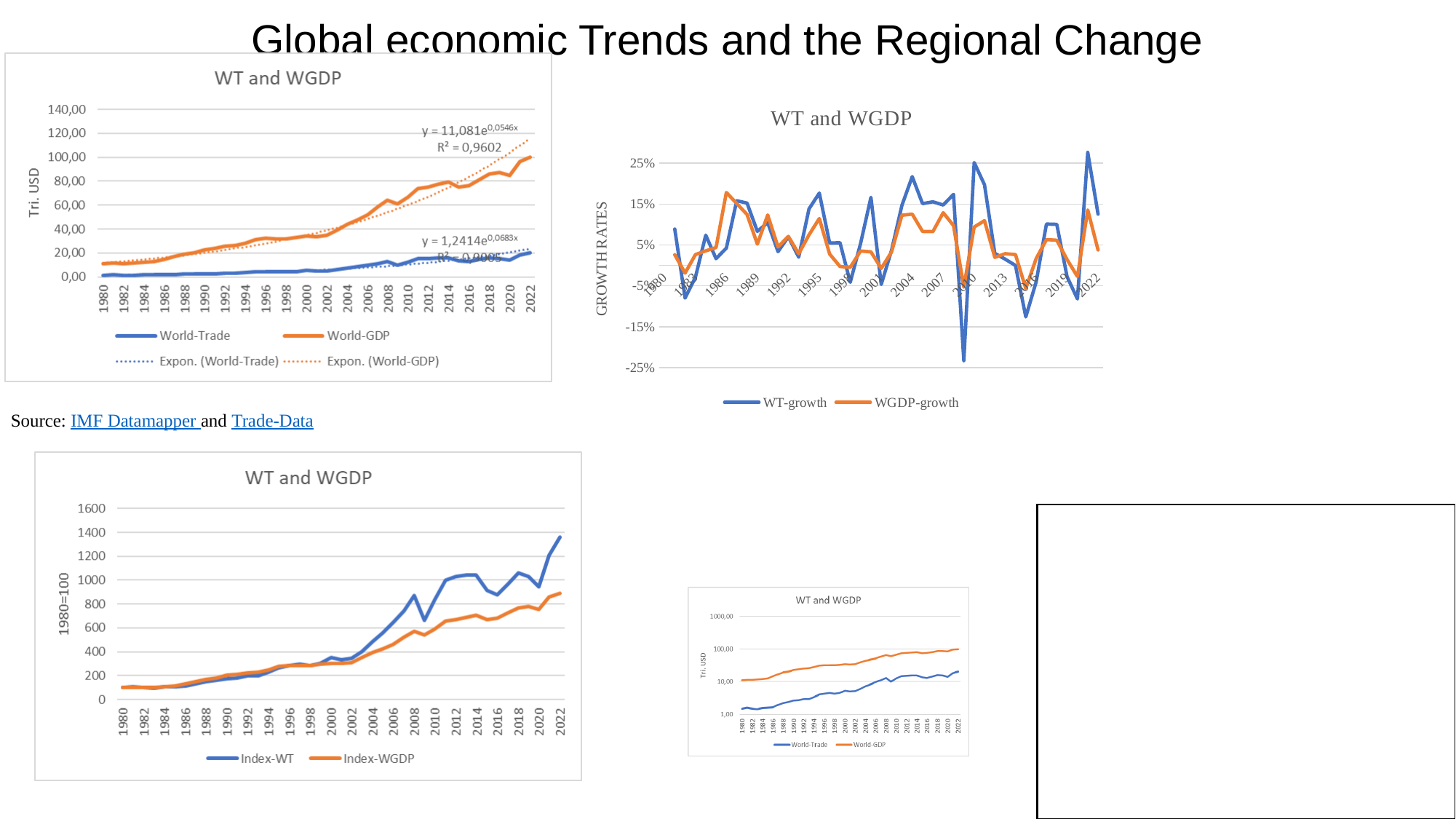
How many entries does the legend of the top-left chart list? 4 In the top-left chart, what is the R² value shown for the exponential trendline of World-GDP? R² = 0,9602 In the bottom-left chart, which series is higher in 2022, Index-WT or Index-WGDP? Index-WT What is the y-axis label of the bottom-left chart? 1980=100 In the top-left chart, is the World-Trade value for 2022 greater or less than 40,00? less In the bottom-left chart, is the Index-WT value for 2022 greater or less than 1200? greater In the top-left chart, does the World-GDP line generally rise or fall from 1980 to 2022? rise How many series does the legend of the top-right chart list? 2 In the top-right chart, is the lowest WT-growth value (around 2009) greater or less than -15%? less What is the y-axis label of the top-right chart titled "WT and WGDP"? GROWTH RATES What type of chart is the top-left chart titled "WT and WGDP"? line chart